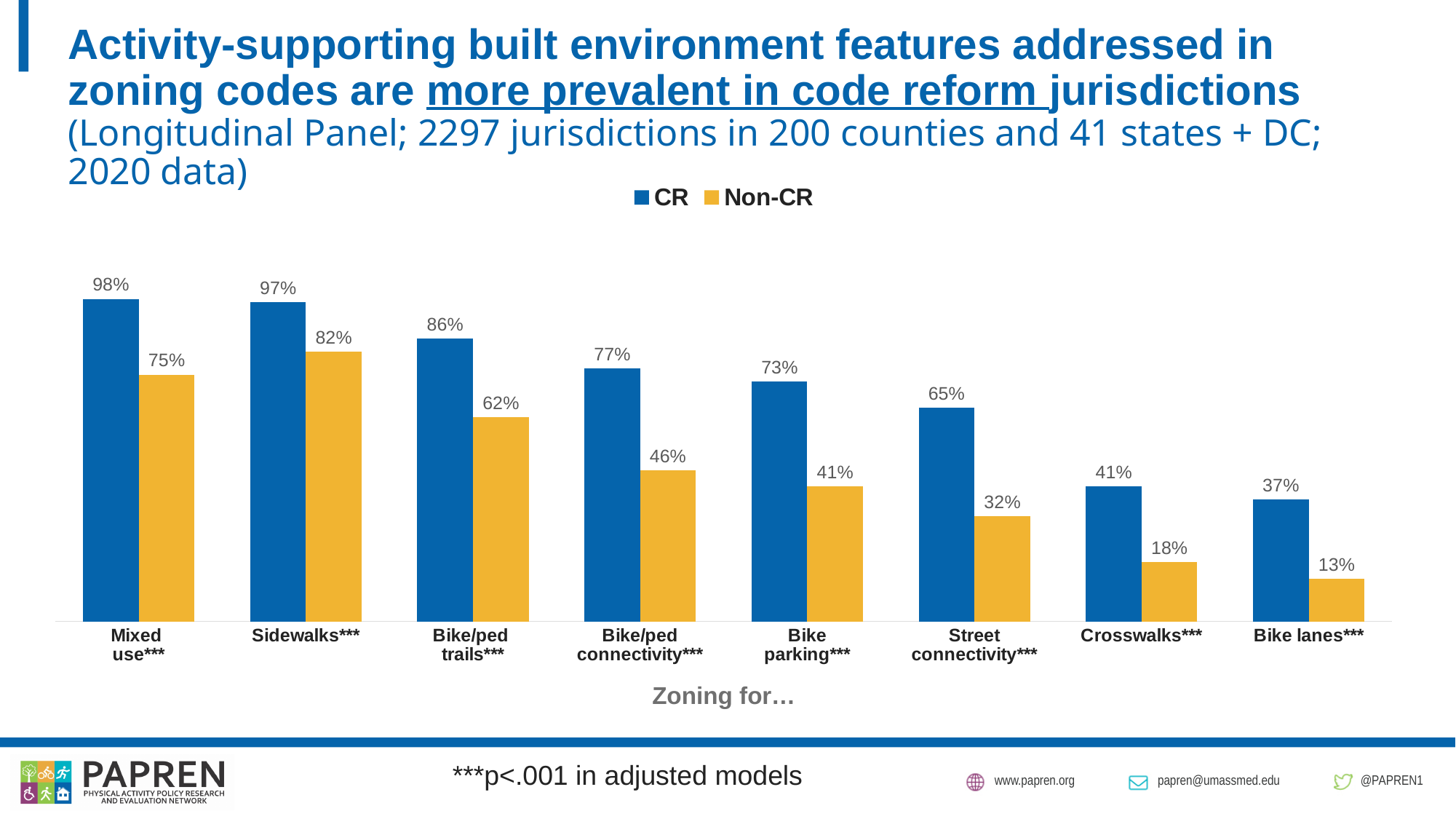
Which category has the highest CR value? Mixed use What is the CR value for Mixed use? 98% What is the Non-CR value for Bike lanes? 13% What is the difference between the CR and Non-CR values for Crosswalks? 23% Which category has the lowest Non-CR value? Bike lanes How many series does the legend list? 2 Do the CR values rise or fall from left to right across the categories? Fall What is the Non-CR value for Street connectivity? 32% What is the difference between the CR and Non-CR values for Bike/ped connectivity? 31% How many categories are shown on the x axis? 8 Which is larger: the Non-CR value for Sidewalks or the CR value for Bike parking? Non-CR value for Sidewalks What kind of chart is shown on the slide? Bar chart